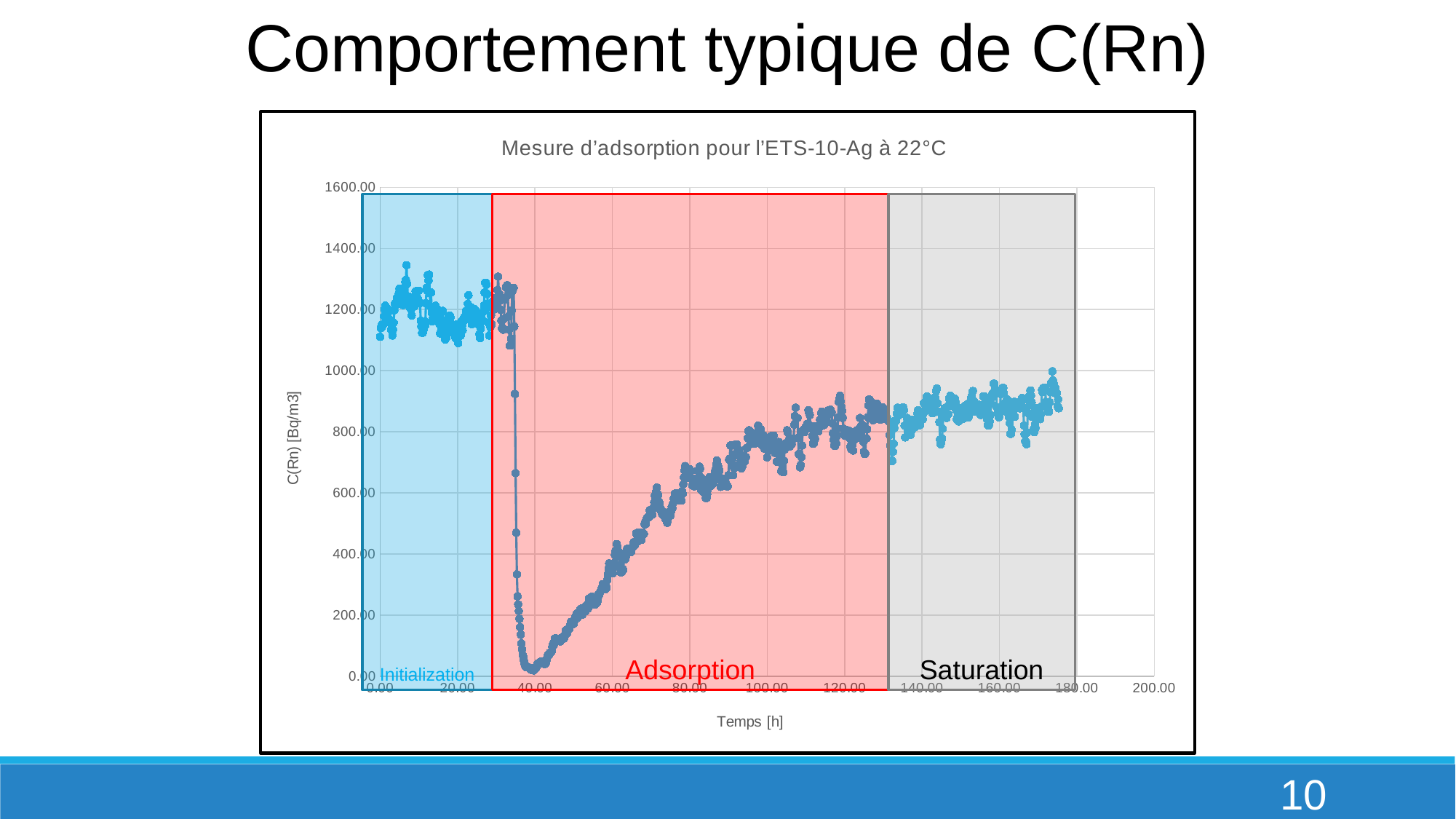
What are the three phases labelled on the chart, from left to right? Initialization, Adsorption, Saturation In which phase does the chart reach its lowest values? Adsorption Which is larger, the value of C(Rn) at about 10 h or at about 160 h? at about 10 h What kind of chart is shown on the slide? scatter chart Is the value of C(Rn) at about 40 h greater or less than 200? less In which phase does the chart reach its highest values? Initialization Do the values rise or fall along the x axis between about 40 h and 120 h? rise Is the value of C(Rn) at about 10 h greater or less than 1000? greater Is the value of C(Rn) at about 160 h greater or less than 600? greater Do the values rise or fall along the x axis between about 30 h and 40 h? fall What is the title of the chart? Mesure d'adsorption pour l'ETS-10-Ag à 22°C